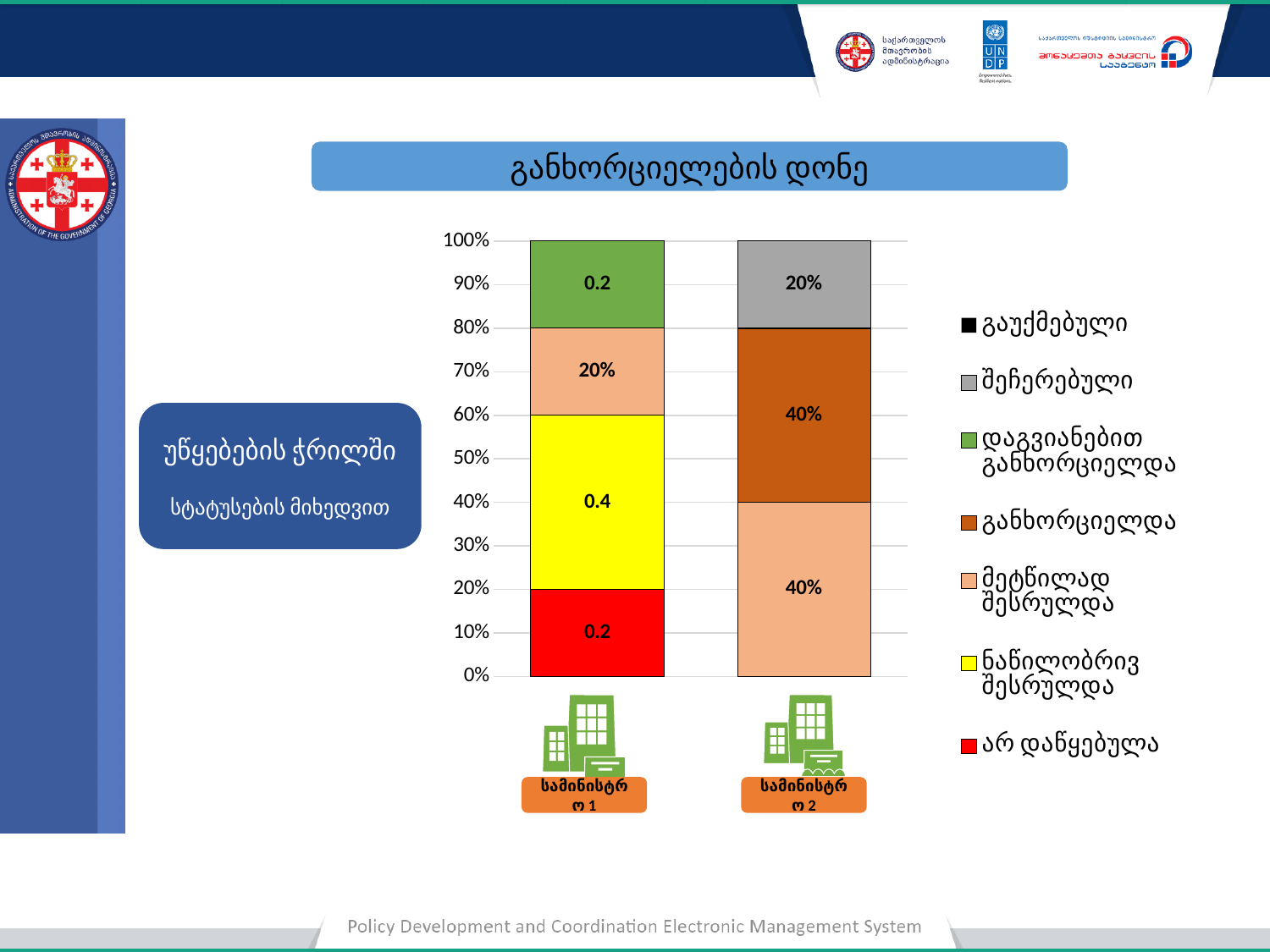
What kind of chart is shown on the slide? Stacked bar chart What is the title of the chart? განხორციელების დონე Which status makes up the largest segment of the სამინისტრო 1 bar? ნაწილობრივ შესრულდა What is the value of განხორციელდა for სამინისტრო 2? 40% What is the value of მეტწილად შესრულდა for სამინისტრო 2? 40% Which ministry has the larger share of მეტწილად შესრულდა, სამინისტრო 1 or სამინისტრო 2? სამინისტრო 2 What is the value of დაგვიანებით განხორციელდა for სამინისტრო 1? 0.2 What is the value of არ დაწყებულა for სამინისტრო 1? 0.2 What is the value of შეჩერებული for სამინისტრო 2? 20% What is the value of ნაწილობრივ შესრულდა for სამინისტრო 1? 0.4 How many bars (categories) are plotted in the chart? 2 How many series does the legend list? 7